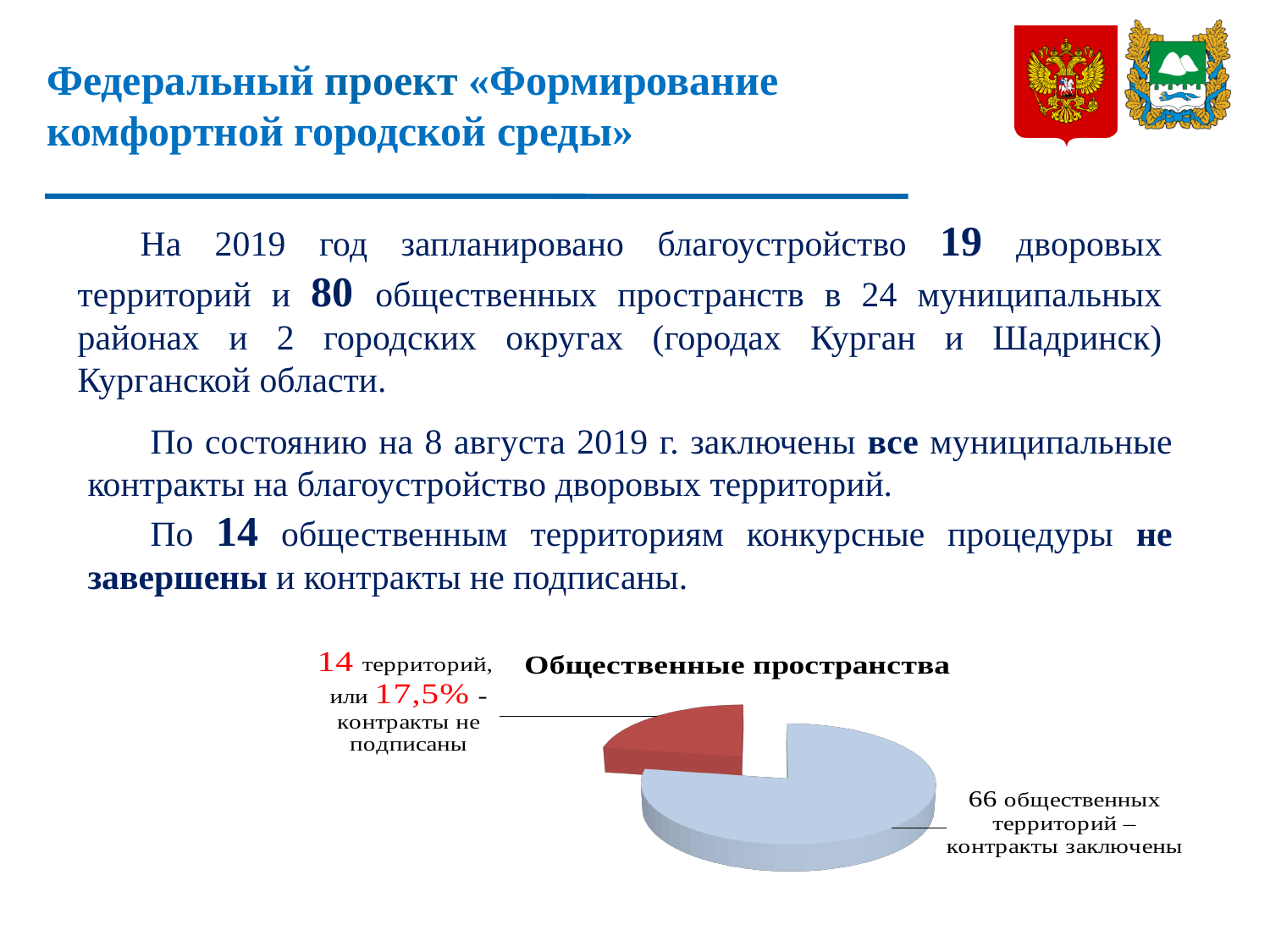
What colour is the slice for territories with contracts not signed? red What is the difference between the number of territories with contracts concluded and those with contracts not signed? 52 How many slices does the pie chart have? 2 How many public territories have contracts concluded (контракты заключены) according to the chart? 66 Which is larger: the number of territories with contracts concluded or the number with contracts not signed? contracts concluded (66) What kind of chart is shown on the slide? pie chart Which slice of the pie is the largest? 66 общественных территорий – контракты заключены Which slice of the pie is the smallest? 14 территорий – контракты не подписаны What is the title of the chart? Общественные пространства What share of the pie do the territories with unsigned contracts represent? 17,5% How many territories have contracts not signed (контракты не подписаны) according to the chart? 14 What is the total number of public territories represented in the pie chart? 80